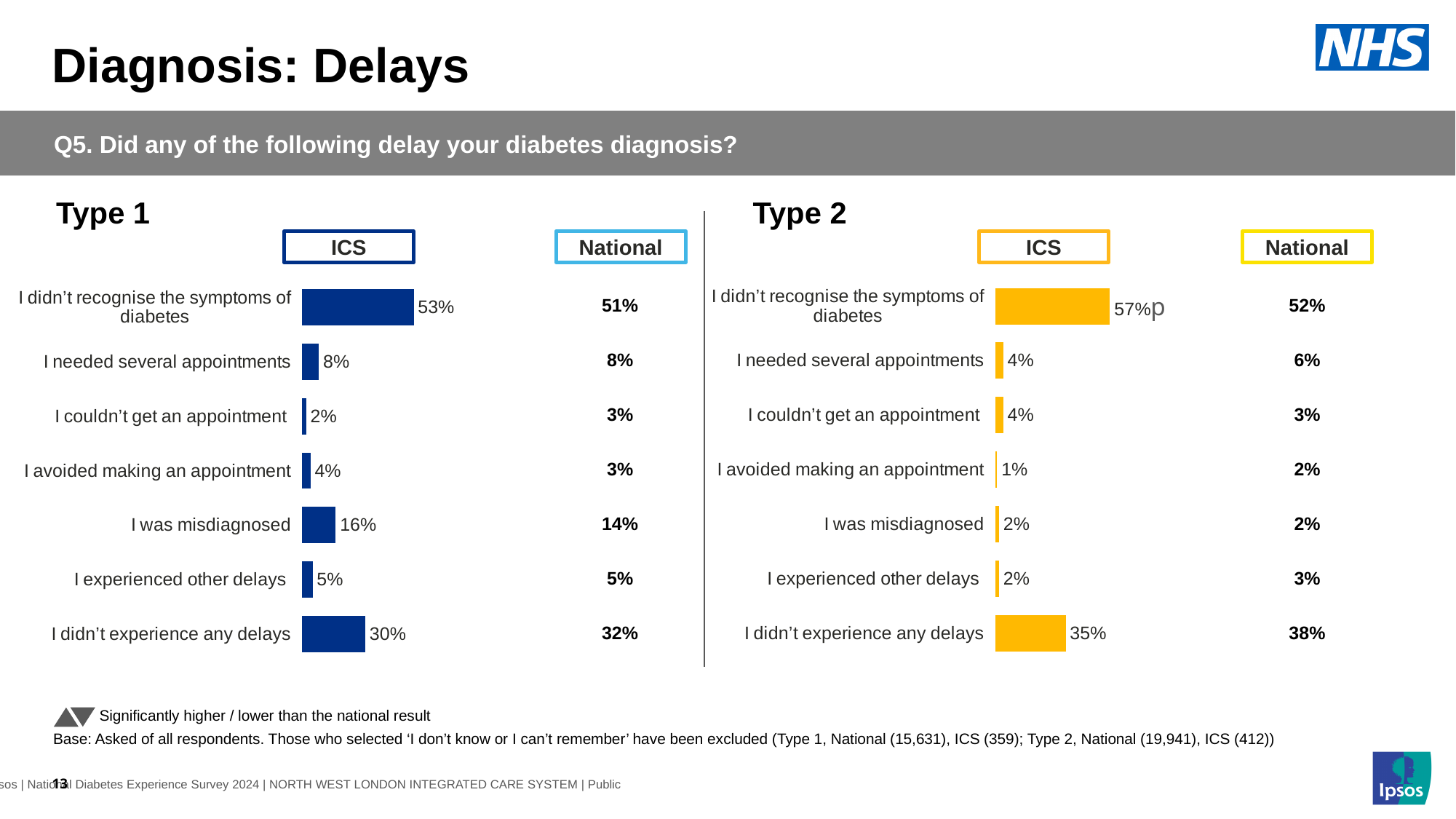
What type of chart is used to show the ICS values in the Type 2 chart? Bar chart In the Type 1 chart, which category has the highest ICS value? I didn't recognise the symptoms of diabetes In the Type 2 chart, which is larger for 'I didn't recognise the symptoms of diabetes': the ICS value or the National value? ICS How many categories are shown in the Type 1 chart? 7 In the Type 1 chart, what is the ICS value for 'I didn't recognise the symptoms of diabetes'? 53% In the Type 2 chart, what is the difference between the National and ICS values for 'I didn't experience any delays'? 3% In the Type 2 chart, which category has the lowest ICS value? I avoided making an appointment In the Type 2 chart, what is the ICS value for 'I didn't experience any delays'? 35% In the Type 1 chart, what is the National value for 'I was misdiagnosed'? 14% In the Type 2 chart, what is the National value for 'I needed several appointments'? 6% In the Type 1 chart, what is the difference between the ICS and National values for 'I was misdiagnosed'? 2% What colour are the ICS bars in the Type 2 chart? Yellow/orange